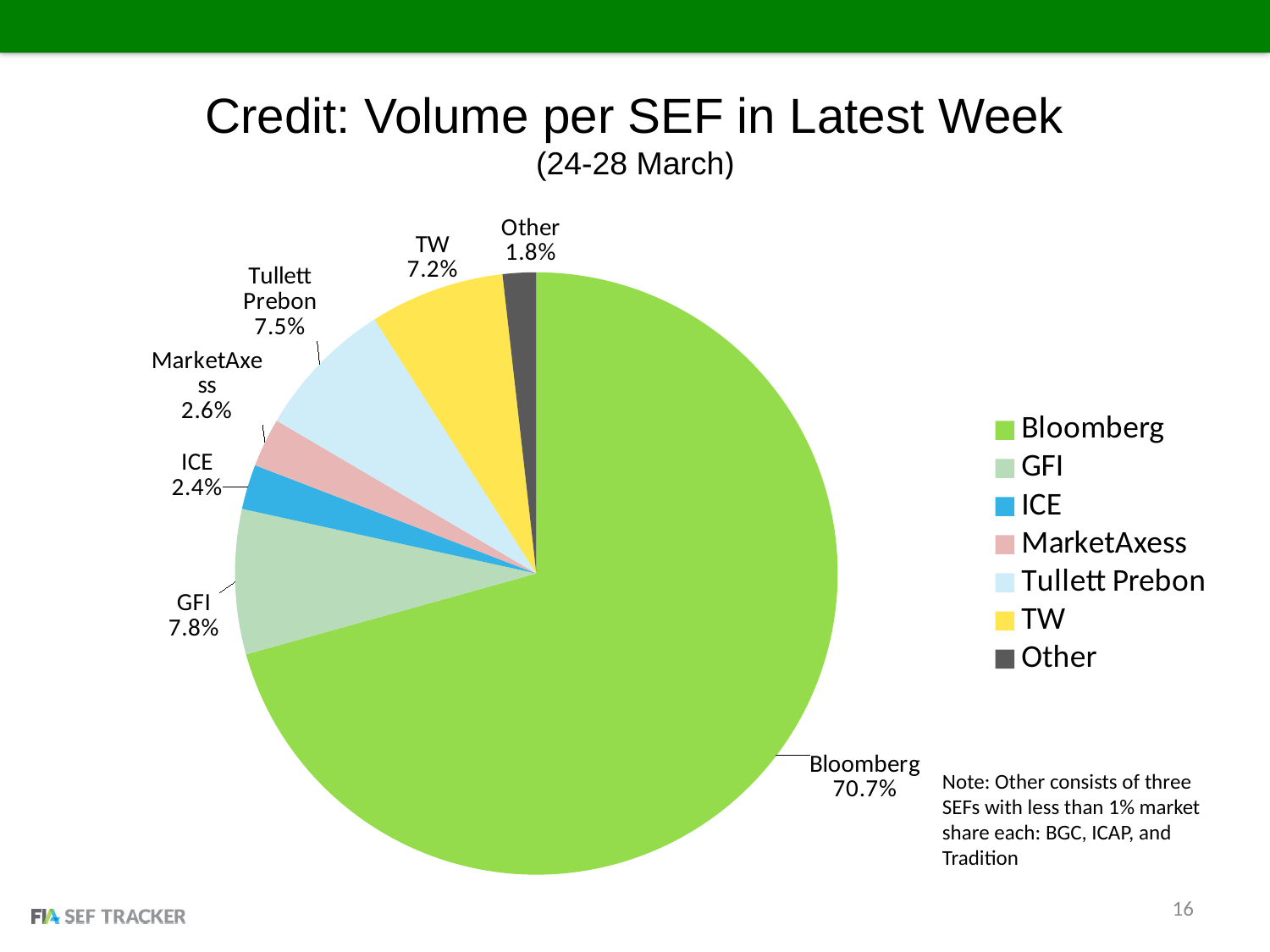
Which has a larger share, MarketAxess or ICE? MarketAxess What share of credit volume does ICE have? 2.4% What is the difference in share between GFI and TW? 0.6% How many slices does the pie chart have? 7 What share of credit volume does Tullett Prebon have? 7.5% What is the title of the chart? Credit: Volume per SEF in Latest Week (24-28 March) How many entries does the legend list? 7 Which SEF has the largest share of credit volume? Bloomberg What share of credit volume does GFI have? 7.8% Which slice has the smallest share of credit volume? Other What type of chart is shown on the slide? pie chart